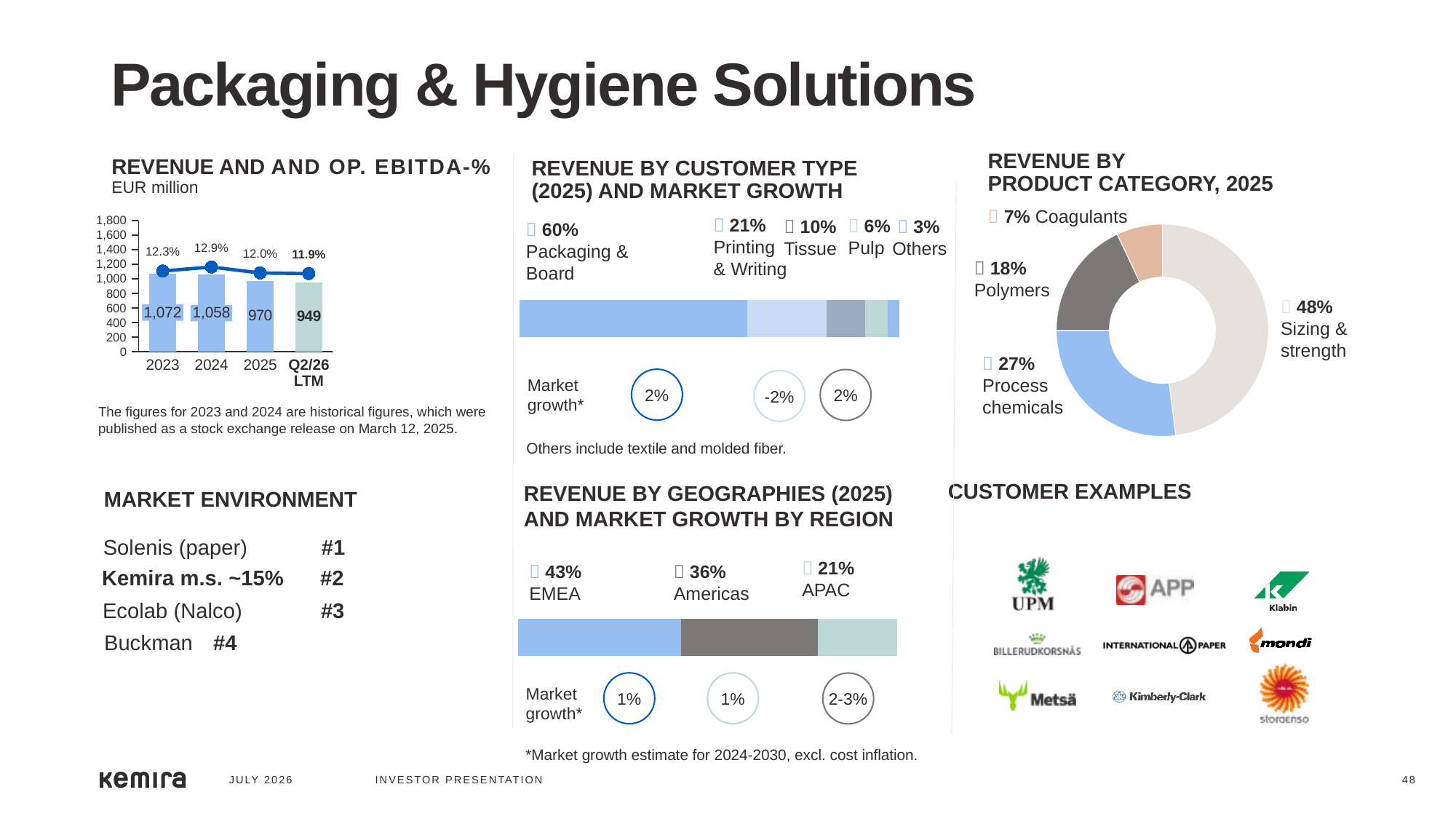
In the 'Revenue and Op. EBITDA-%' chart, what is the Op. EBITDA-% for 2024? 12.9% In the 'Revenue by product category, 2025' chart, which category has the largest share? Sizing & strength In the 'Revenue by customer type (2025)' chart, what share of revenue comes from Tissue? 10% In the 'Revenue and Op. EBITDA-%' chart, what is the revenue for 2023? 1,072 In the 'Revenue by product category, 2025' chart, what is the share of Process chemicals? 27% In the 'Revenue by geographies (2025)' chart, which is larger, EMEA or Americas? EMEA In the 'Revenue and Op. EBITDA-%' chart, which period has the lowest revenue? Q2/26 LTM In the 'Revenue and Op. EBITDA-%' chart, does revenue rise or fall from 2023 to Q2/26 LTM? fall What kind of chart is the 'Revenue by product category, 2025' chart? Donut chart In the 'Revenue by customer type (2025)' chart, what is the market growth for Printing & Writing? -2% In the 'Revenue and Op. EBITDA-%' chart, what is the difference in revenue between 2023 and 2025? 102 In the 'Revenue and Op. EBITDA-%' chart, how many periods are shown on the x axis? 4